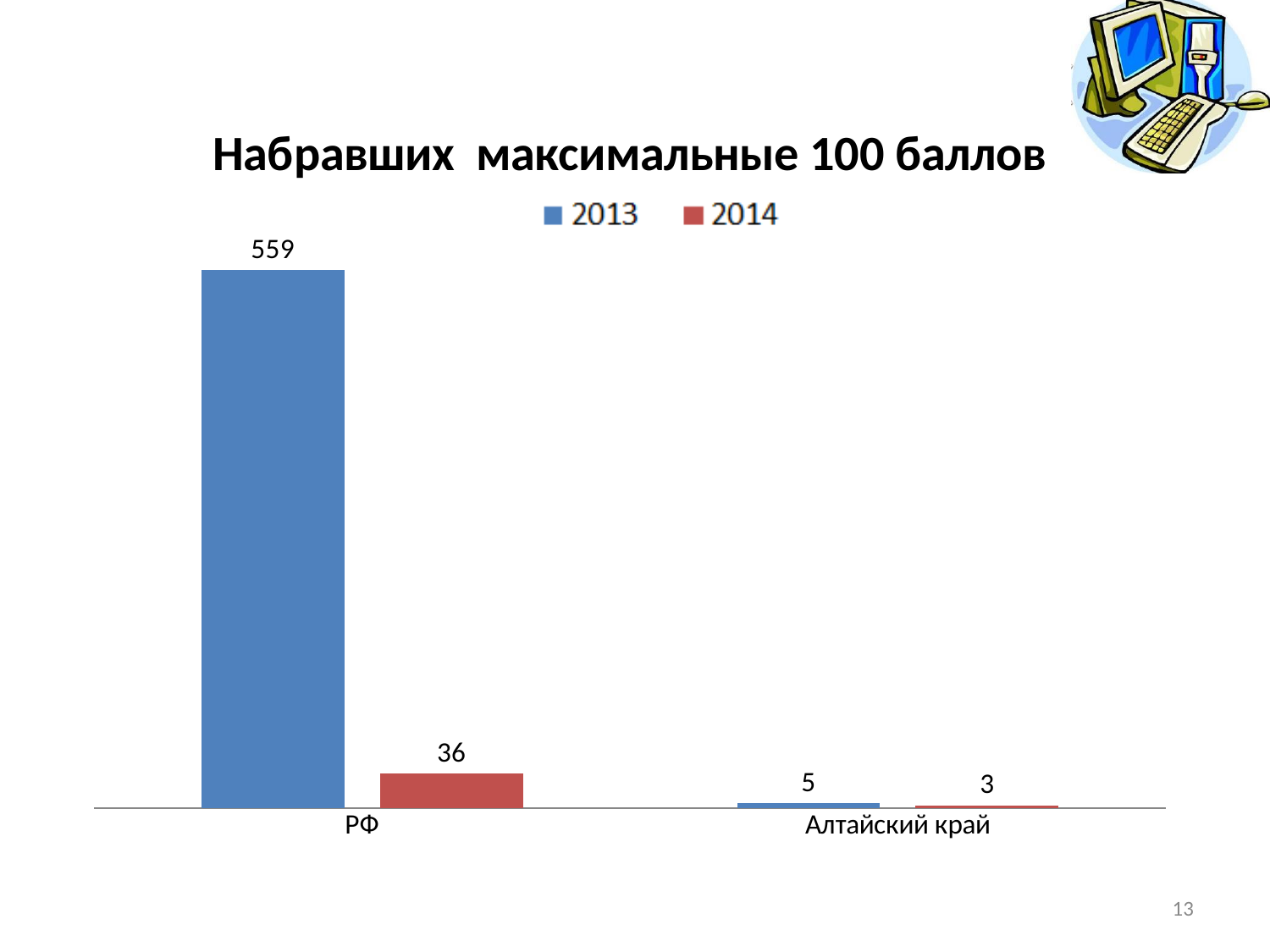
What is the value for РФ in 2014? 36 How many categories are shown on the x axis? 2 Which category has the highest value in the 2013 series? РФ What is the difference between the 2013 and 2014 values for Алтайский край? 2 Which is larger: the 2014 value for РФ or the 2013 value for Алтайский край? 2014 value for РФ Which category has the lowest value in the 2014 series? Алтайский край What is the value for Алтайский край in 2014? 3 How many series does the legend list? 2 What type of chart is shown on the slide? Bar chart What is the value for РФ in 2013? 559 What is the value for Алтайский край in 2013? 5 What is the difference between the 2013 and 2014 values for РФ? 523